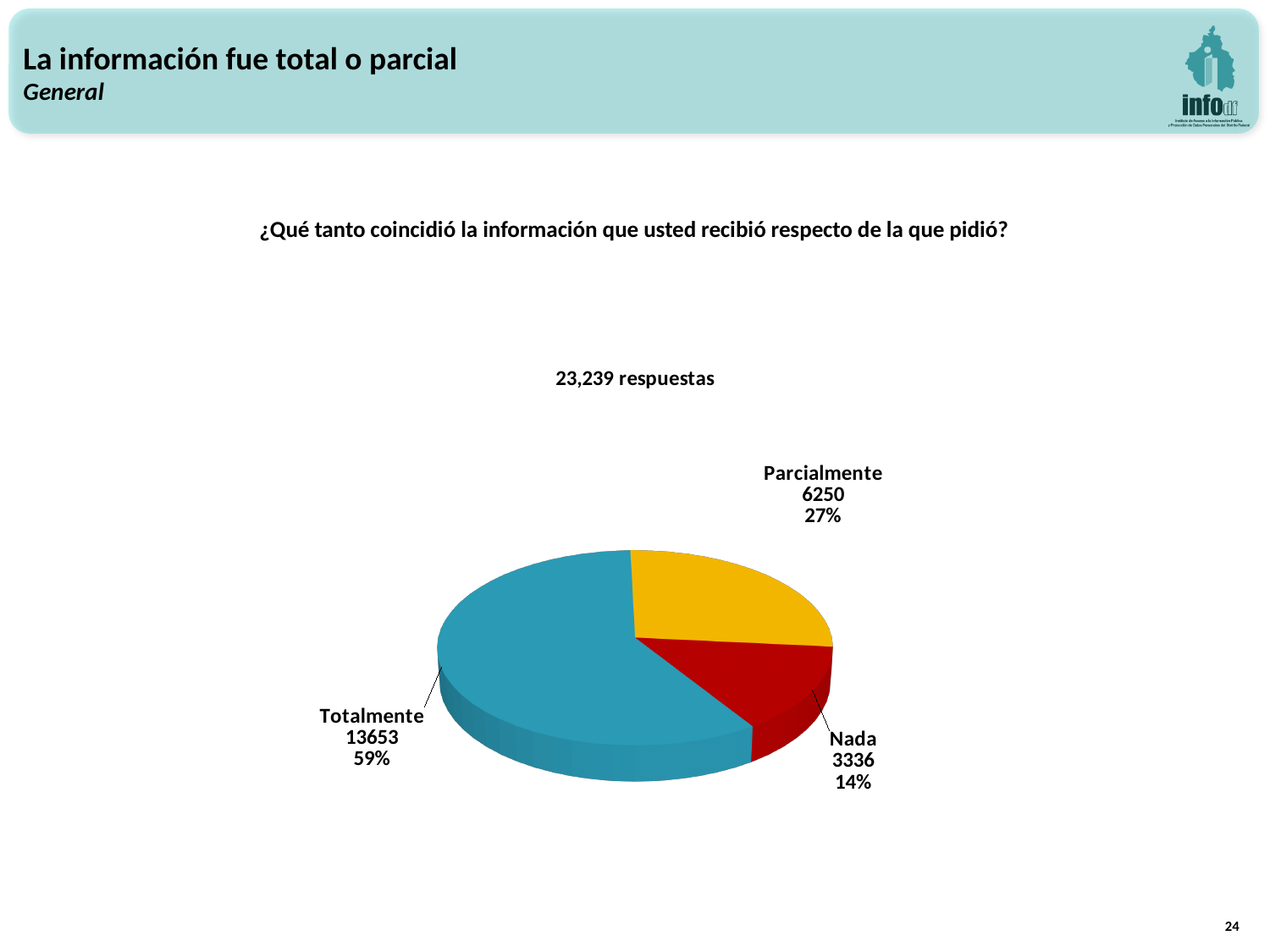
What is the value for Parcialmente? 6250 What is the value for Totalmente? 13653 How many responses does the chart report in total? 23,239 respuestas Which category has the smallest slice? Nada Which is larger, Parcialmente or Nada? Parcialmente What is the difference between the values for Parcialmente and Nada? 2914 What kind of chart is shown on the slide? Pie chart Which category has the largest slice? Totalmente What share of the pie does Nada represent? 14% What is the value for Nada? 3336 How many slices does the pie chart have? 3 What share of the pie does Totalmente represent? 59%